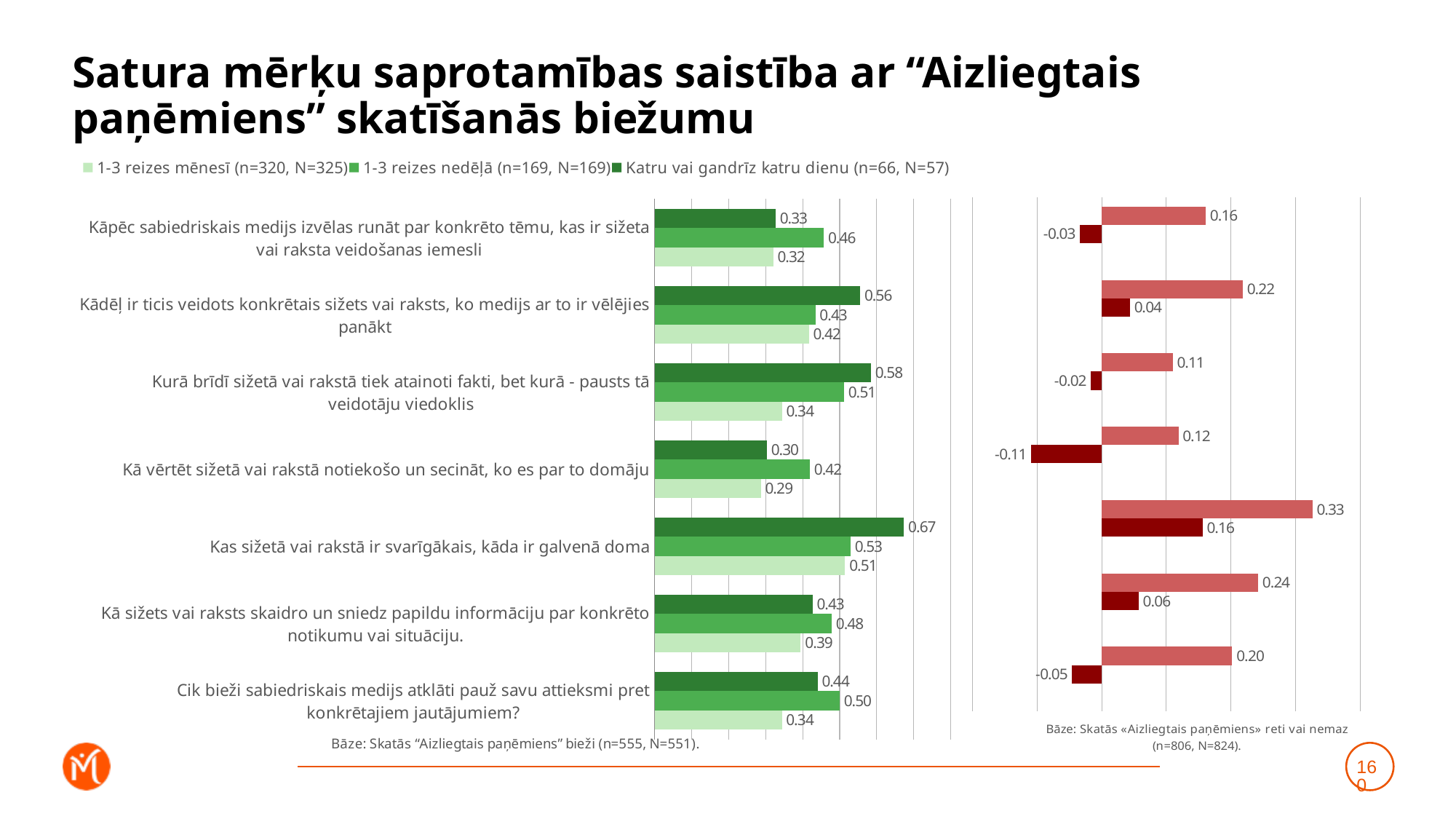
How many series does the legend of the left (green) chart list? 3 In the right (red) chart, what is the lowest value shown among the dark red bars? -0.11 In the left (green) chart, what is the difference between the "Katru vai gandrīz katru dienu" and "1-3 reizes mēnesī" values for "Kurā brīdī sižetā vai rakstā tiek atainoti fakti, bet kurā - pausts tā veidotāju viedoklis"? 0.24 In the left (green) chart, for "Kāpēc sabiedriskais medijs izvēlas runāt par konkrēto tēmu, kas ir sižeta vai raksta veidošanas iemesli", which is larger: the "1-3 reizes nedēļā" value or the "Katru vai gandrīz katru dienu" value? 1-3 reizes nedēļā In the left (green) chart, what is the value for "Katru vai gandrīz katru dienu" for "Kas sižetā vai rakstā ir svarīgākais, kāda ir galvenā doma"? 0.67 How many categories are shown in the left (green) chart? 7 In the left (green) chart, what is the value for "1-3 reizes nedēļā" for "Cik bieži sabiedriskais medijs atklāti pauž savu attieksmi pret konkrētajiem jautājumiem?"? 0.50 In the left (green) chart, which category has the lowest value for "1-3 reizes mēnesī"? Kā vērtēt sižetā vai rakstā notiekošo un secināt, ko es par to domāju In the right (red) chart, what is the highest value shown among the light red bars? 0.33 In the left (green) chart, what is the value for "1-3 reizes mēnesī" for "Kā vērtēt sižetā vai rakstā notiekošo un secināt, ko es par to domāju"? 0.29 What kind of chart is the left (green) chart? Bar chart In the left (green) chart, which category has the highest value for "Katru vai gandrīz katru dienu"? Kas sižetā vai rakstā ir svarīgākais, kāda ir galvenā doma